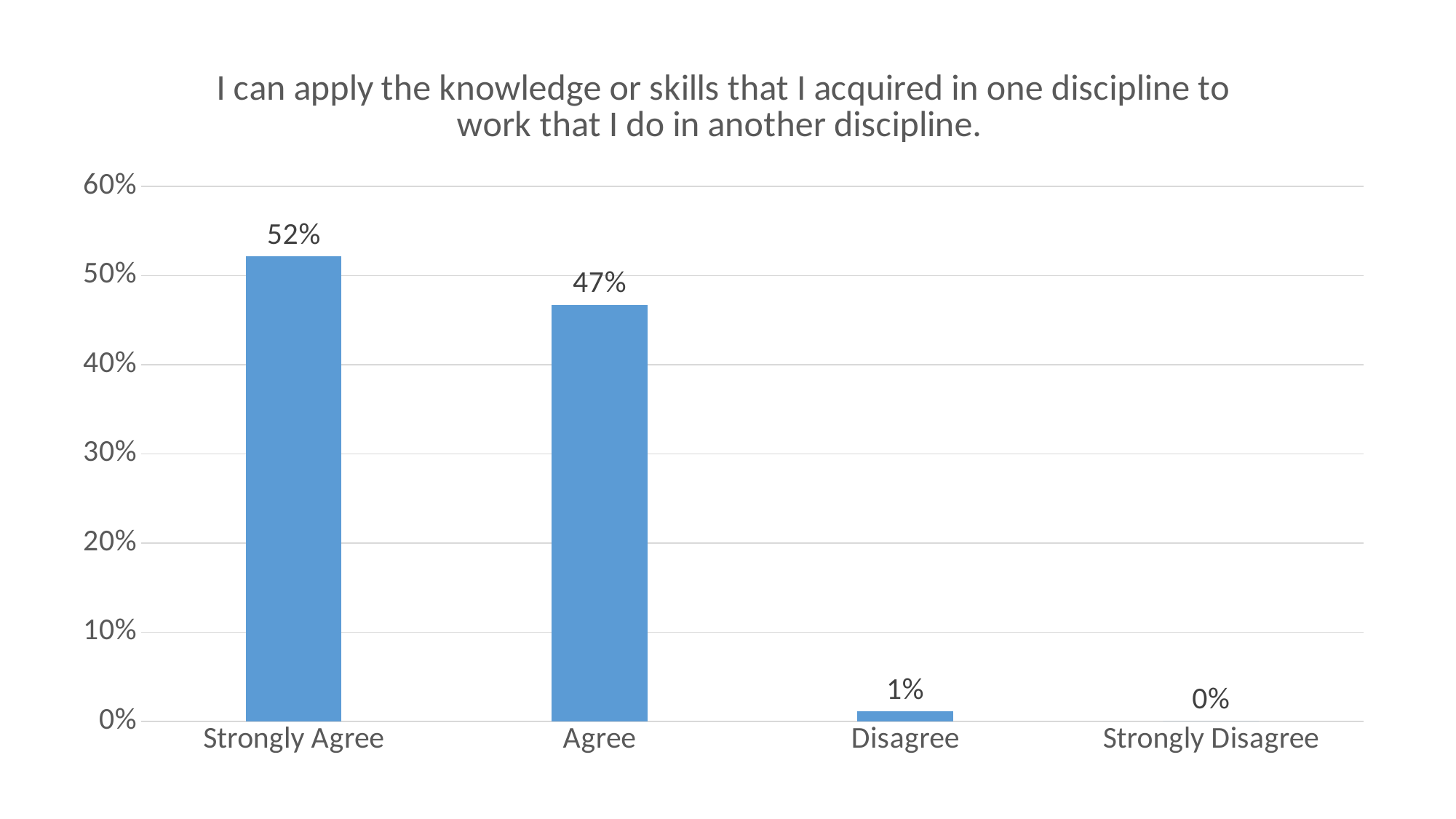
Which response category has the highest value? Strongly Agree What is the difference between the Strongly Agree and Agree values? 5% What is the value for Strongly Disagree? 0% Which response category has the lowest value? Strongly Disagree What kind of chart is shown on the slide? Bar chart How many response categories are shown on the x axis? 4 What percentage of respondents chose Strongly Agree? 52% What is the value shown for Agree? 47% Which is larger, the value for Agree or the value for Disagree? Agree What percentage is shown for Disagree? 1% Do the values rise or fall moving from Strongly Agree to Strongly Disagree along the x axis? Fall Is the value for Agree greater or less than 40%? greater